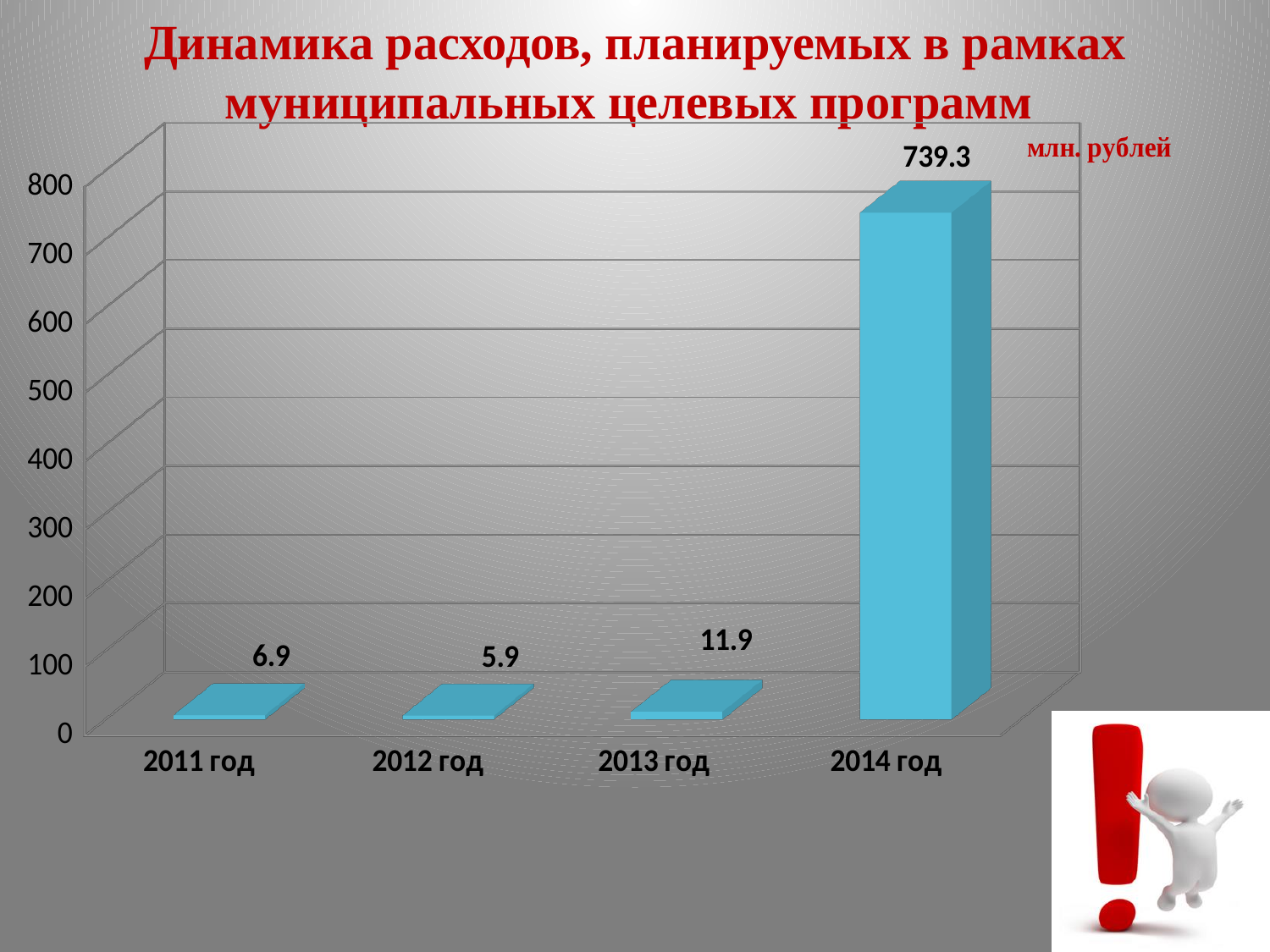
Which year has the highest value? 2014 год What is the difference between the values for 2014 год and 2013 год? 727.4 Which is larger, the value for 2011 год or 2013 год? 2013 год What is the value for 2012 год? 5.9 What is the value for 2014 год? 739.3 How many years are shown on the x axis? 4 Which year has the lowest value? 2012 год What is the value for 2013 год? 11.9 What kind of chart is shown on the slide? bar chart What unit is indicated for the values on the chart? млн. рублей What is the value for 2011 год? 6.9 Is the value for 2014 год greater or less than 700? greater